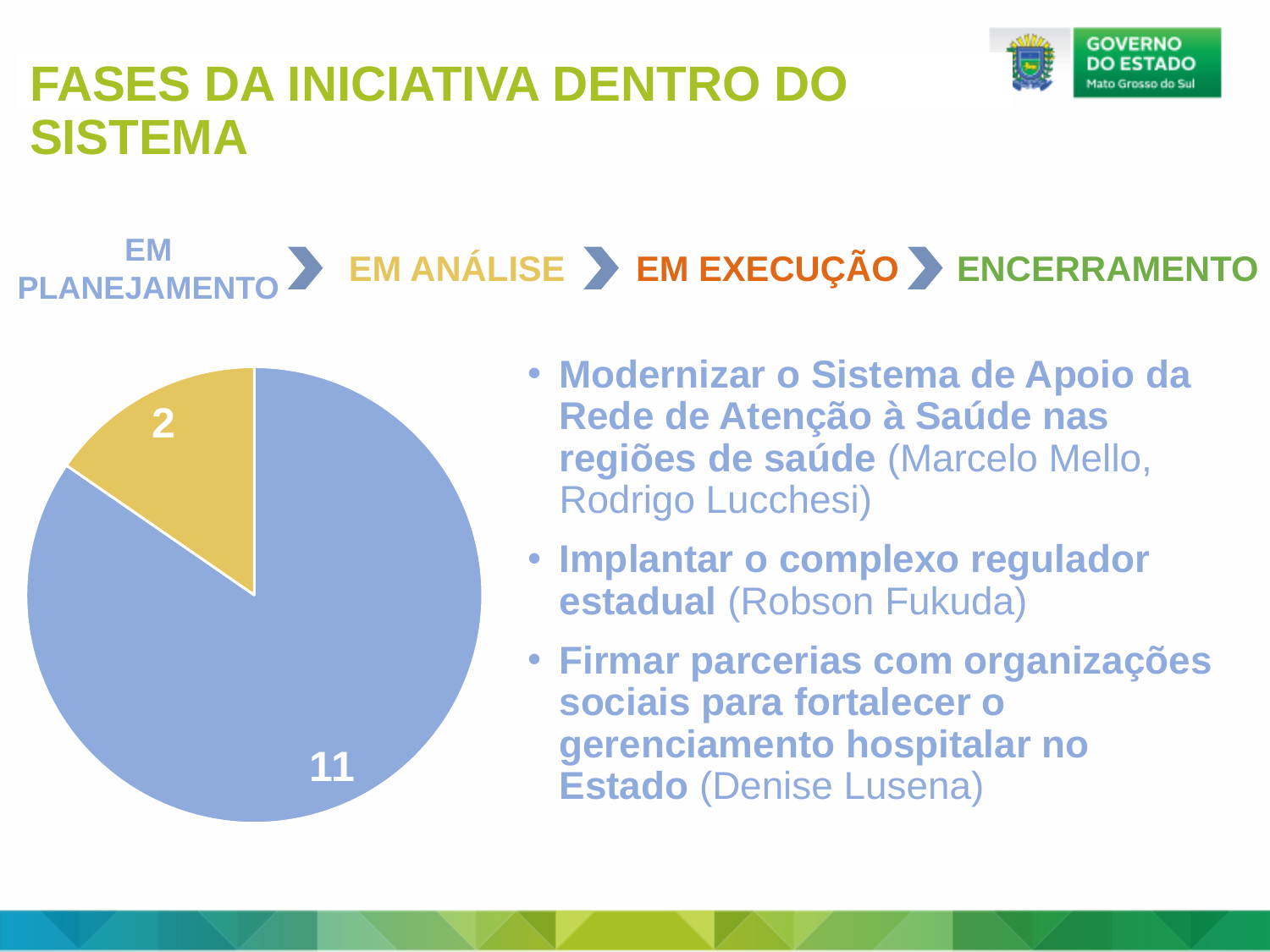
How many slices does the pie chart have? 2 What is the difference between the two values shown in the pie chart? 9 What colour is the slice with the value 11? blue Is the value of the blue slice greater or less than 10? greater What kind of chart is shown on the slide? pie chart Which slice of the pie chart has the smallest value? the yellow slice (2) Is the blue slice or the yellow slice of the pie chart larger? the blue slice What value is printed on the blue slice of the pie chart? 11 What is the total of the values shown in the pie chart? 13 What fraction of the pie chart's total does the slice labelled 2 represent? 2/13 What value is printed on the yellow slice of the pie chart? 2 Which slice of the pie chart has the largest value? the blue slice (11)